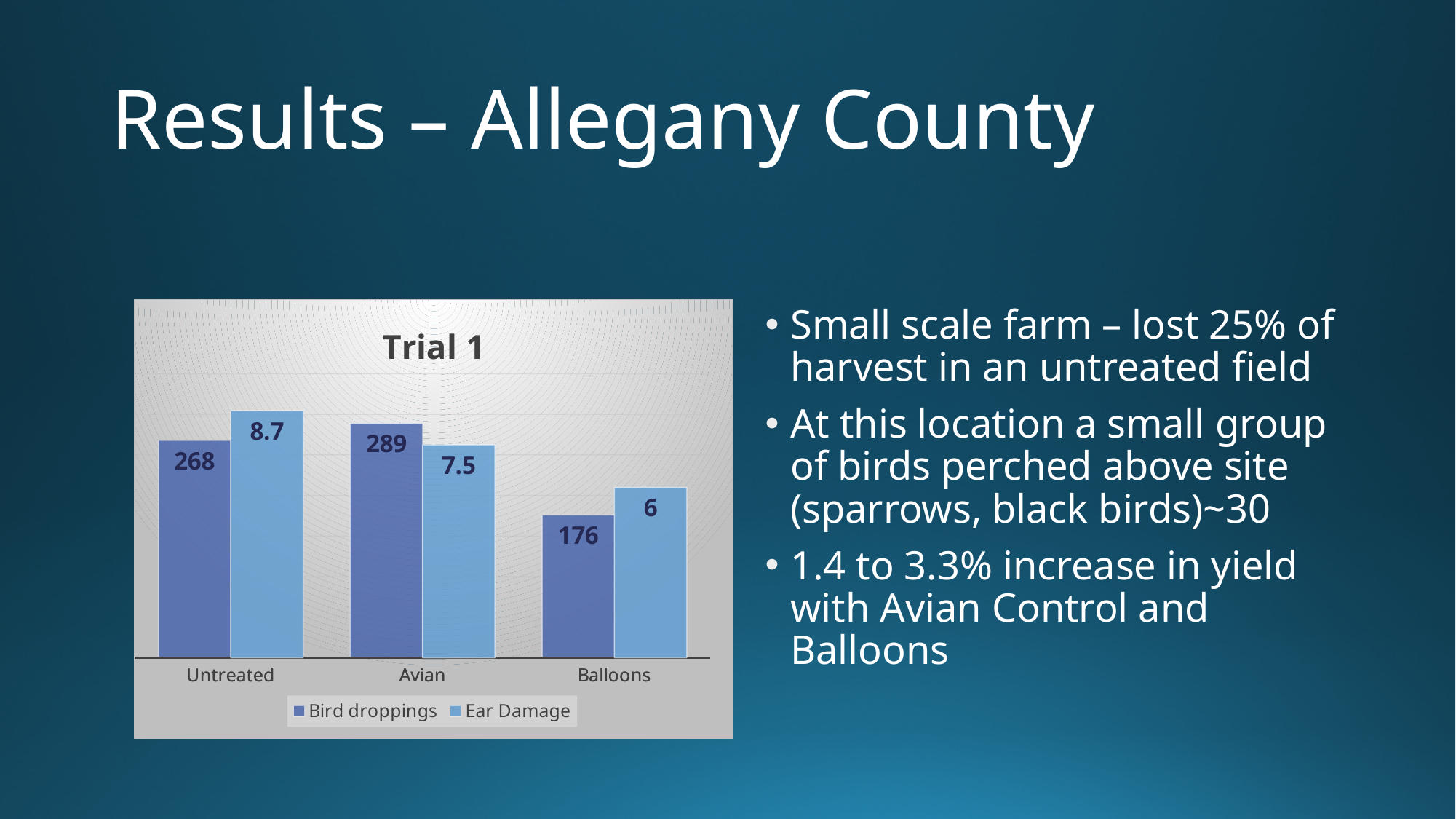
How many categories are shown on the x axis? 3 What is the Ear Damage value for Balloons? 6 How many series does the legend list? 2 What is the difference between the Ear Damage values for Untreated and Avian? 1.2 What is the Bird droppings value for Balloons? 176 Which category has the highest Bird droppings value? Avian What is the Bird droppings value for Untreated? 268 What is the title of the chart? Trial 1 What is the Ear Damage value for Avian? 7.5 What is the difference between the Bird droppings values for Avian and Balloons? 113 Which has a larger Bird droppings value, Untreated or Balloons? Untreated Which category has the lowest Ear Damage value? Balloons